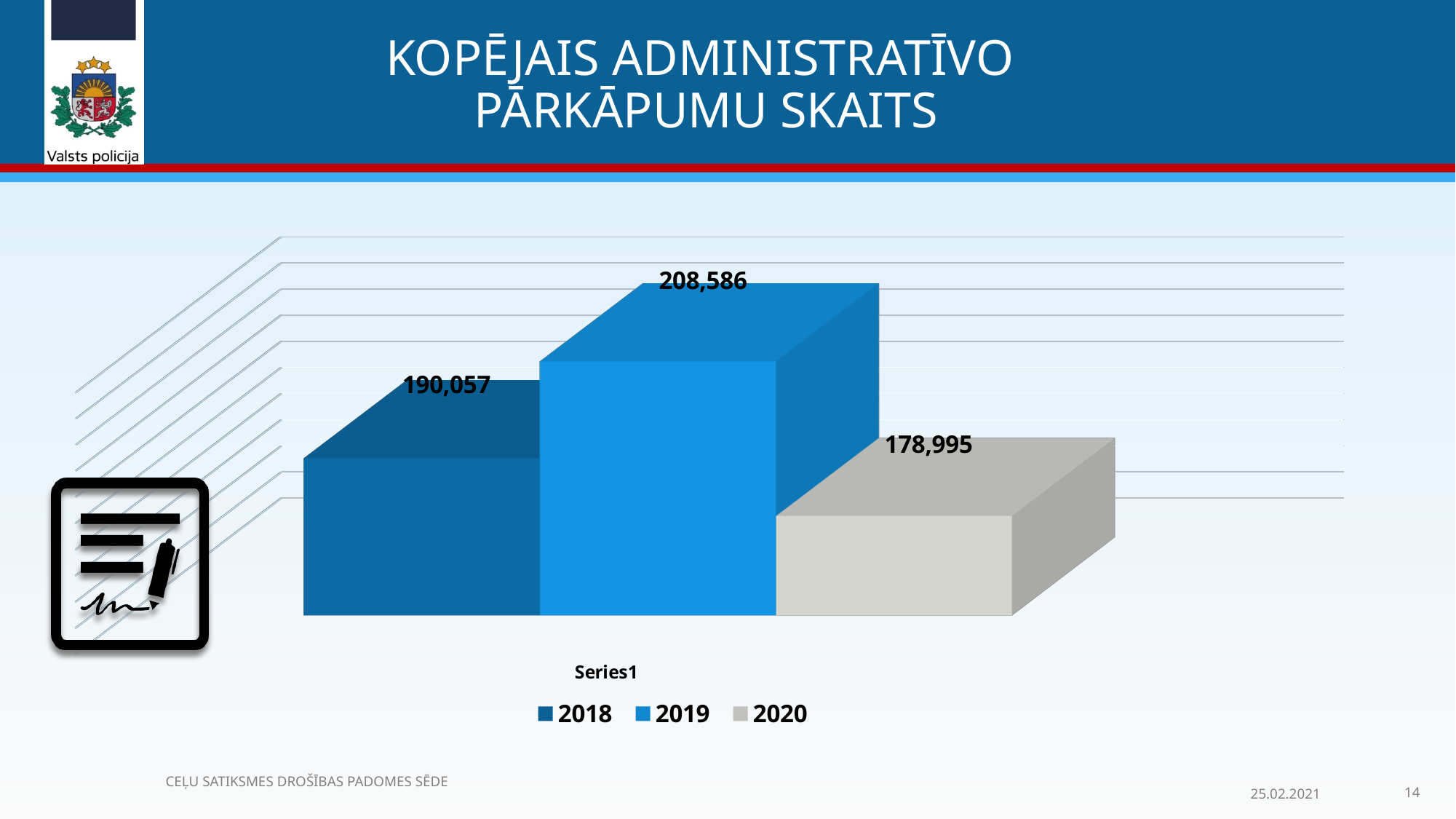
What is the difference between the values for 2019 and 2018? 18,529 How many series does the legend list? 3 Which year has the highest value? 2019 What is the difference between the values for 2018 and 2020? 11,062 Which year has the lowest value? 2020 Which is larger, the value for 2018 or the value for 2020? 2018 What is the value for 2020? 178,995 What is the difference between the values for 2019 and 2020? 29,591 What is the title of the chart on the slide? KOPĒJAIS ADMINISTRATĪVO PĀRKĀPUMU SKAITS What kind of chart is shown on the slide? Bar chart What is the value for 2019? 208,586 What is the value for 2018? 190,057